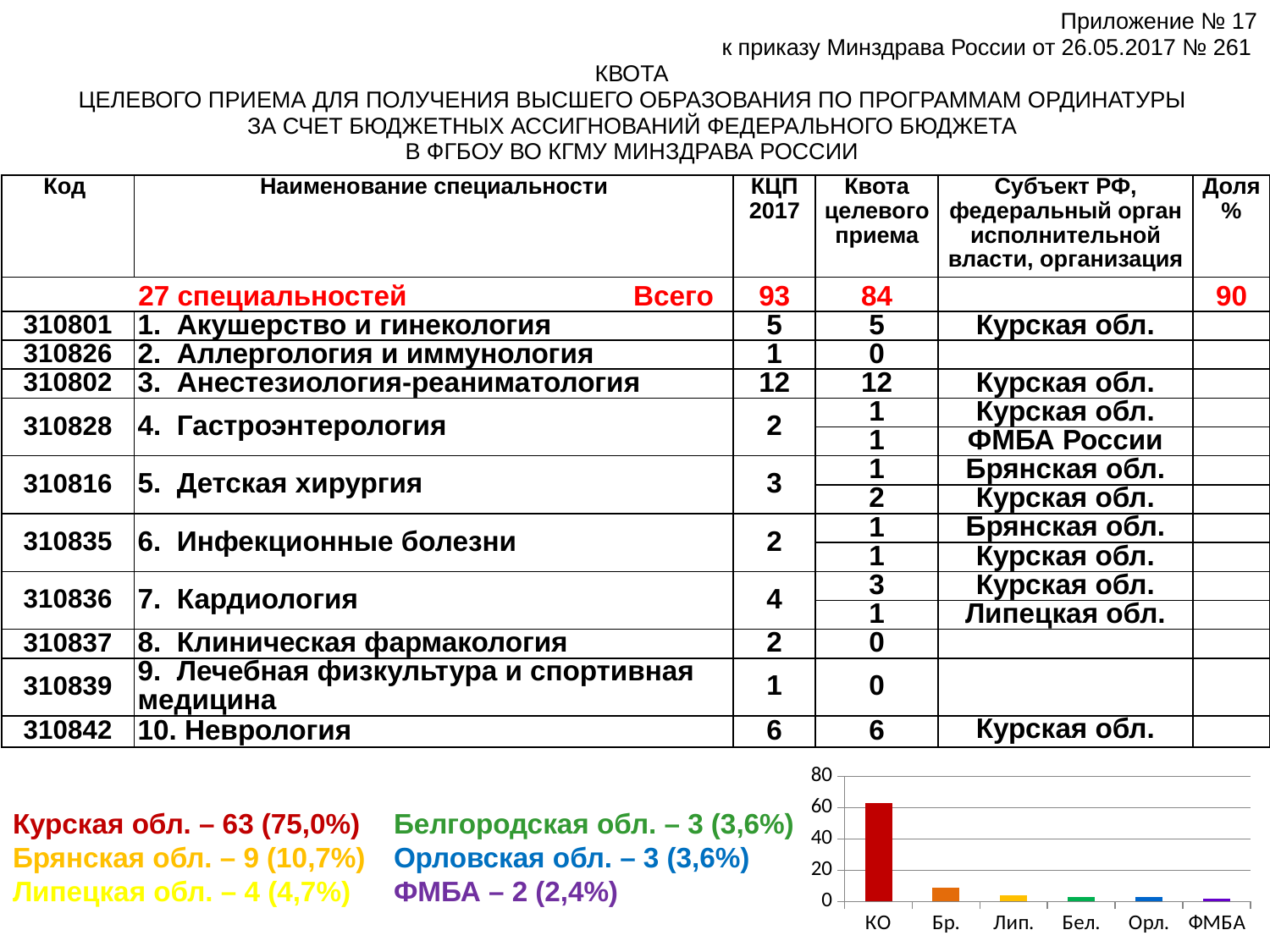
According to the text next to the chart, what value is given for Курская обл.? 63 (75,0%) Which is larger in the chart, the bar for Бр. or the bar for Лип.? Бр. Do the bar values rise or fall from left to right along the x axis? fall Is the value for Лип. greater or less than 20? less How many categories are shown on the x axis of the bar chart? 6 Which category has the highest bar in the chart? КО Is the value for КО greater or less than 40? greater What kind of chart is shown at the bottom right of the slide? bar chart Which is larger in the chart, the bar for КО or the bar for Бр.? КО What is the highest tick value shown on the y axis of the chart? 80 Is the value for Бр. greater or less than 20? less What colour is the bar for КО in the chart? red